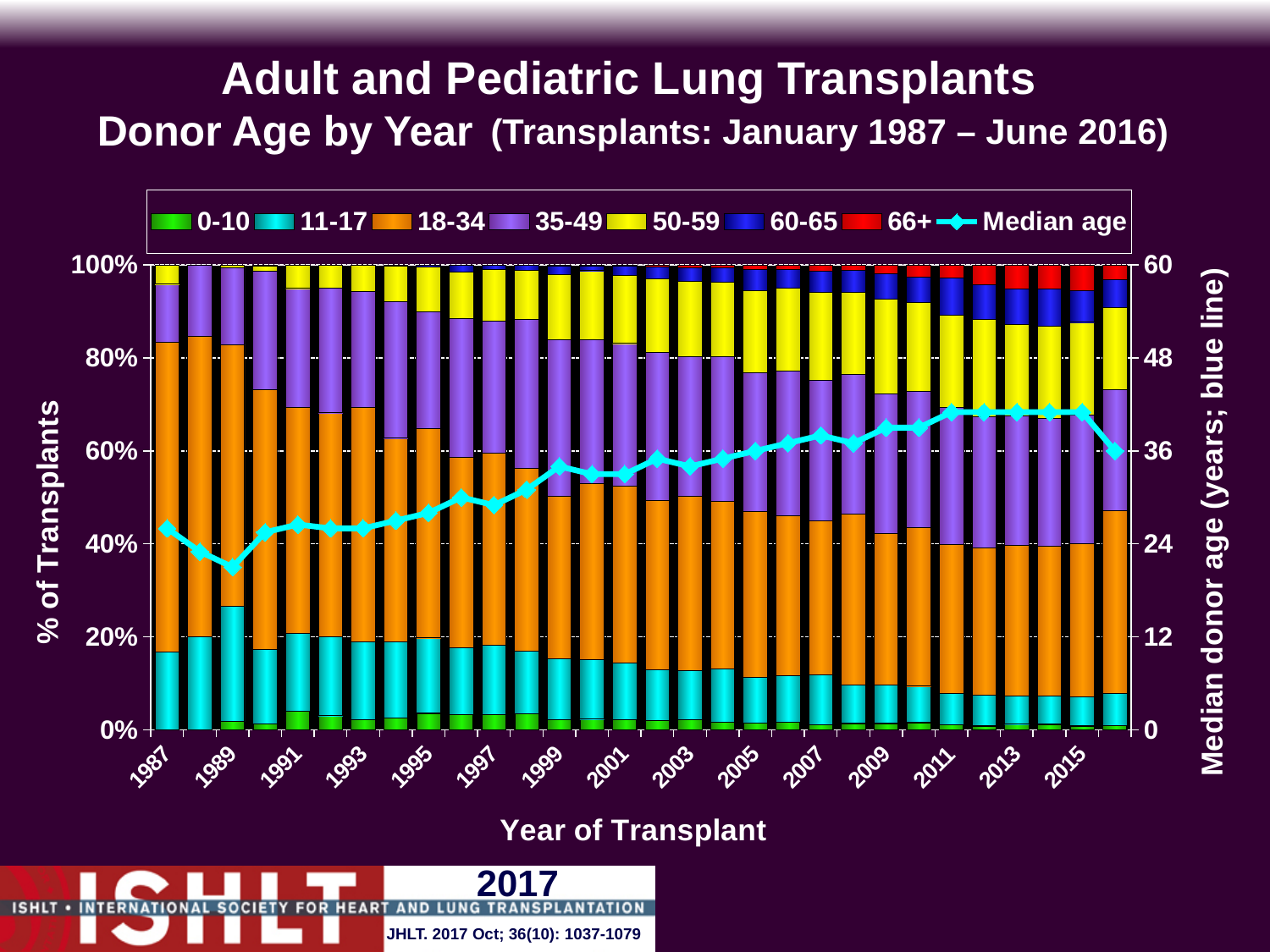
What kind of chart is shown on the slide? Stacked bar chart with a line overlay Which year has the higher median donor age, 1989 or 2011? 2011 Which year has the larger share of 18-34 donors, 1987 or 2015? 1987 What is the label of the right-hand vertical axis? Median donor age (years; blue line) How many series does the legend list? 8 Is the median donor age in 2011 greater or less than 36 years? greater Is the median donor age in 2005 greater or less than 24 years? greater Which year has the lowest median donor age? 1989 Does the median donor age generally rise or fall from 1989 to 2011? rise Is the median donor age in 1997 greater or less than 36 years? less What is the title of the chart? Adult and Pediatric Lung Transplants Donor Age by Year (Transplants: January 1987 – June 2016)